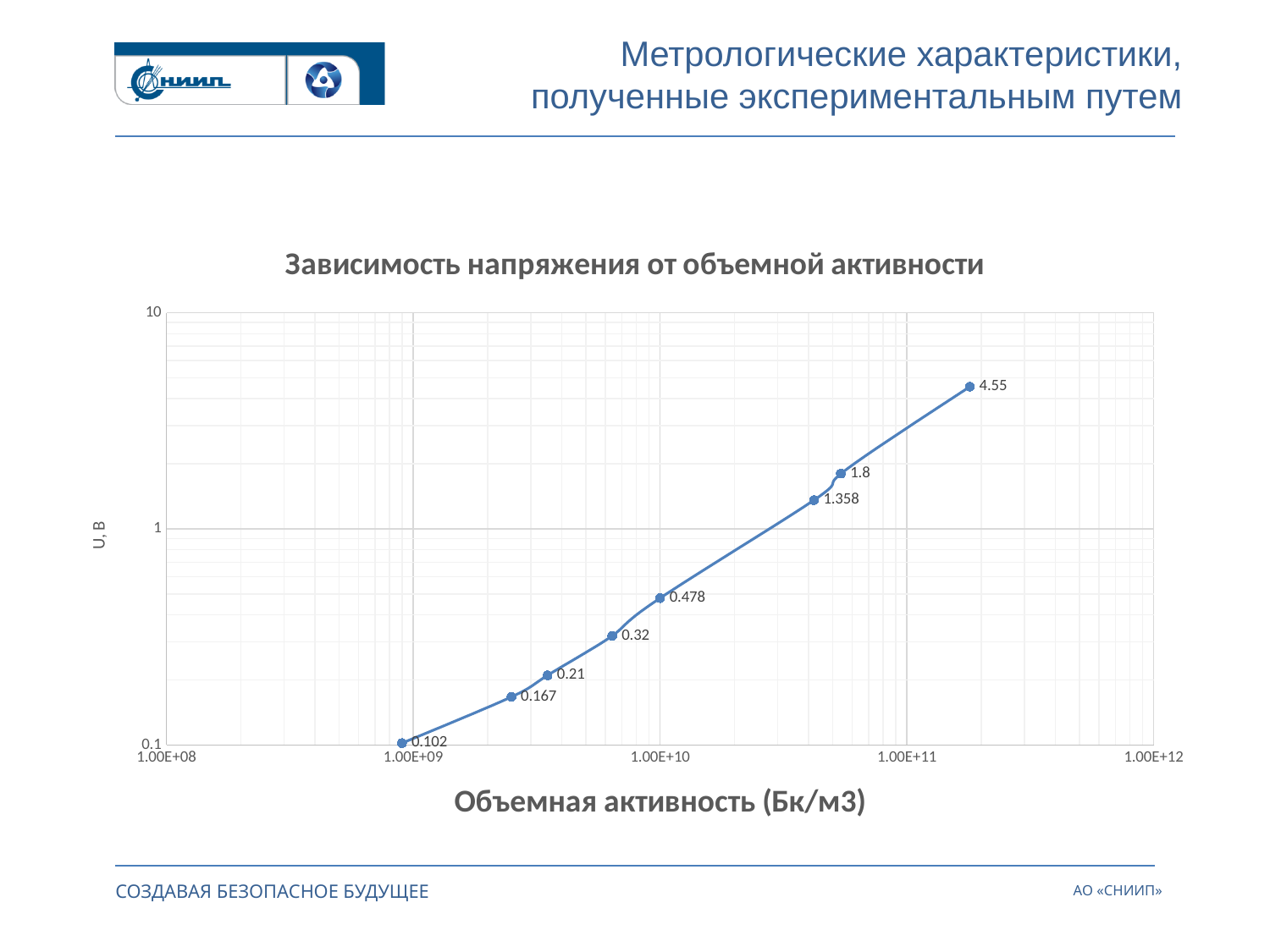
What kind of chart is shown on the slide? line chart Do the values of U rise or fall as the volumetric activity increases along the x axis? rise What is the highest labelled value of U on the chart? 4.55 Is the value of U at the point labelled 1.358 greater or less than 1? greater What is the label of the x axis? Объемная активность (Бк/м3) What is the difference between the highest labelled value (4.55) and the lowest labelled value (0.102)? 4.448 What is the lowest labelled value of U on the chart? 0.102 Which is larger, the labelled value 0.478 or the labelled value 0.32? 0.478 What is the title of the chart? Зависимость напряжения от объемной активности How many data points are plotted on the chart? 8 What is the labelled value of the point immediately after the point labelled 0.21 along the x axis? 0.32 What is the difference between the labelled values 1.8 and 1.358? 0.442